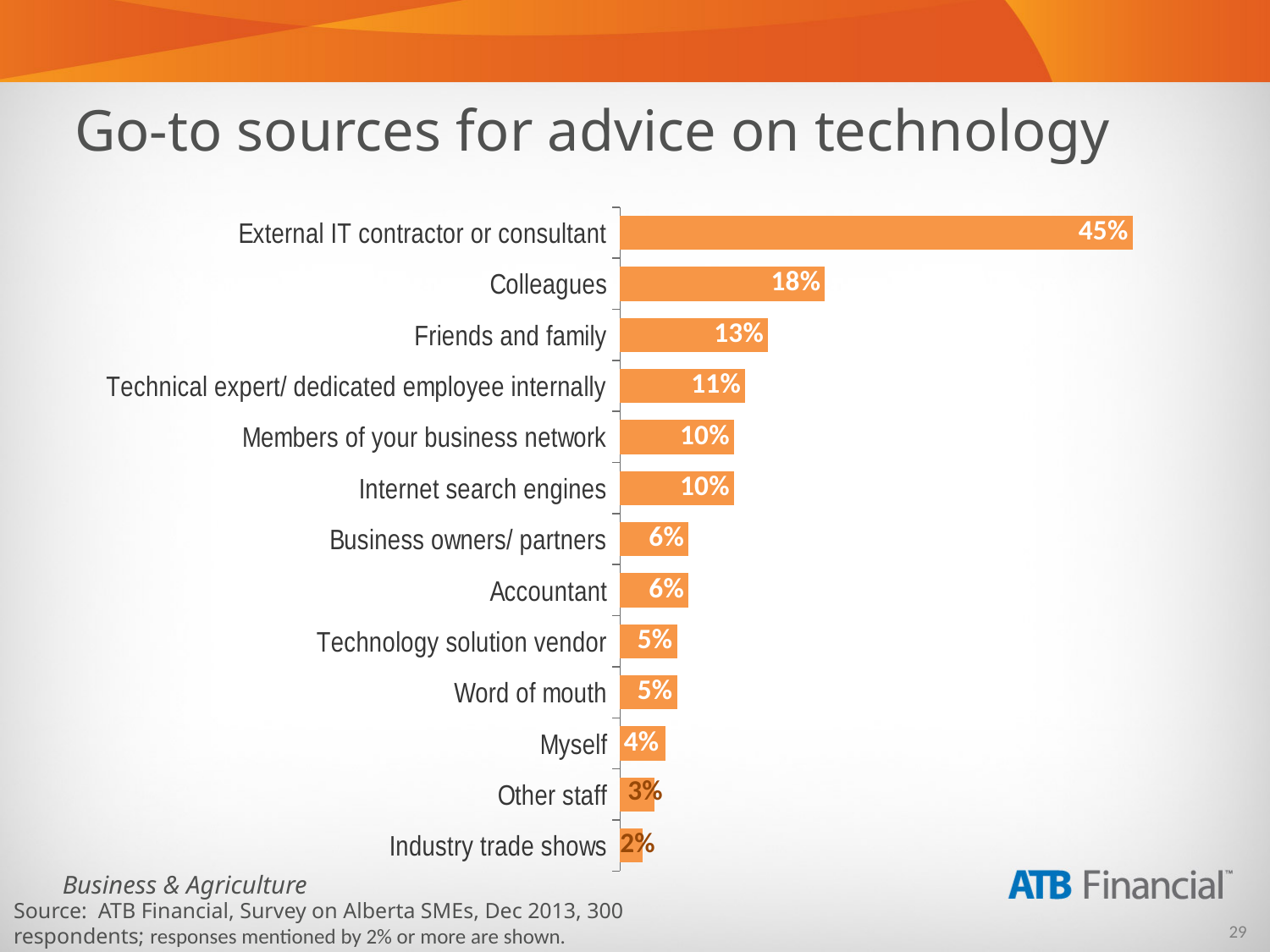
What percentage of respondents cited External IT contractor or consultant as a go-to source for advice on technology? 45% What is the difference between the values for External IT contractor or consultant and Colleagues? 27% What is the title of the chart? Go-to sources for advice on technology How many sources are listed in the chart? 13 What percentage is shown for Internet search engines? 10% Which has a larger value, Technical expert/ dedicated employee internally or Business owners/ partners? Technical expert/ dedicated employee internally Which source has the highest percentage? External IT contractor or consultant What is the value shown for Colleagues? 18% Which source has the lowest percentage? Industry trade shows What is the difference between the values for Friends and family and Myself? 9% What is the value for Industry trade shows? 2% What type of chart is shown on the slide? Bar chart